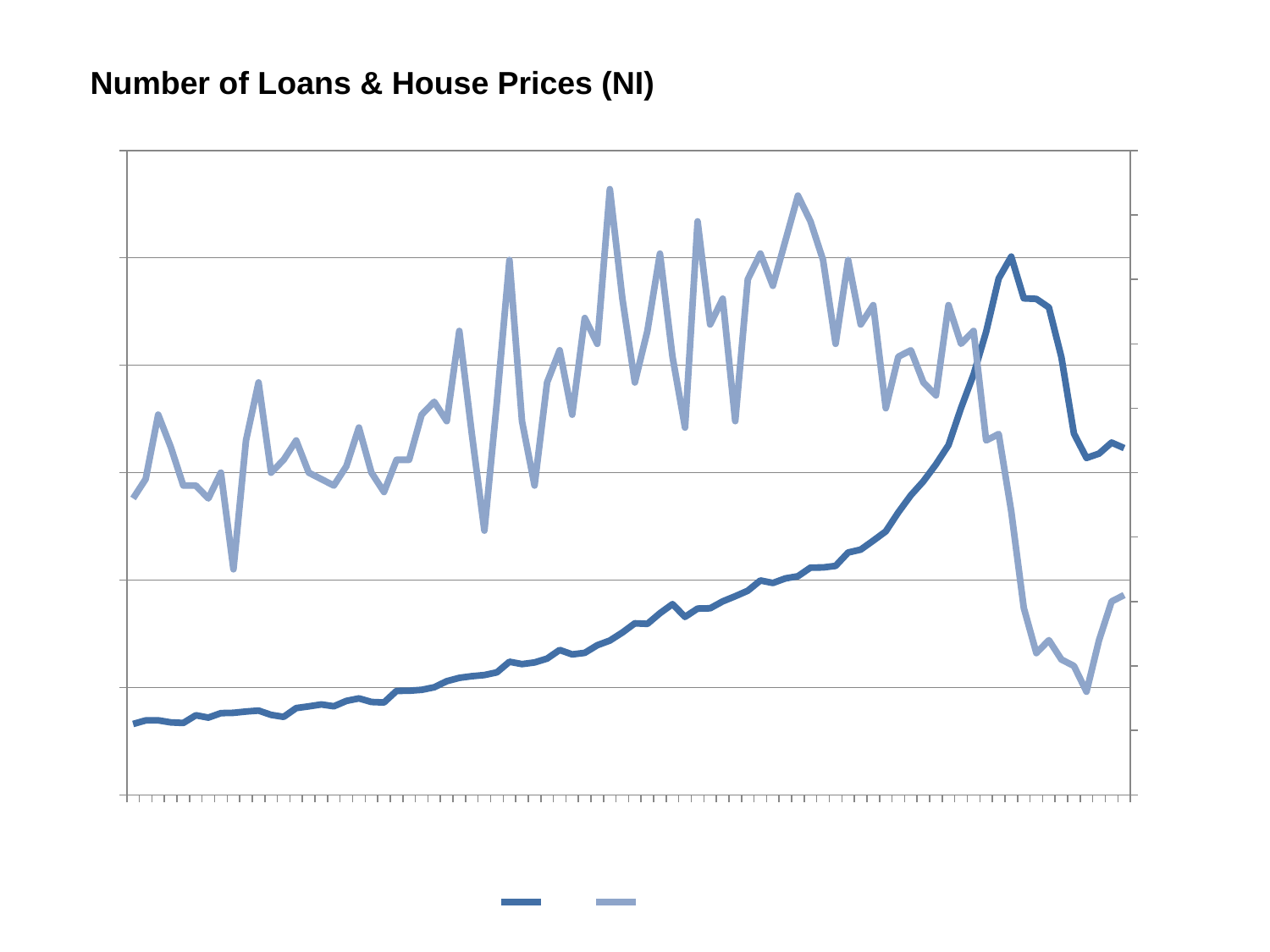
Which line is higher at the right edge of the chart, the dark blue line or the light blue line? dark blue line What kind of chart is shown on the slide? line chart Does the dark blue line rise or fall from the left edge of the chart up to its peak near the right side? rise What two colours are used for the lines in the chart? dark blue and light blue How many series does the legend list? 2 Which line is higher at the left edge of the chart, the dark blue line or the light blue line? light blue line After reaching its peak near the right side of the chart, does the dark blue line rise or fall? fall What is the title of the chart? Number of Loans & House Prices (NI)